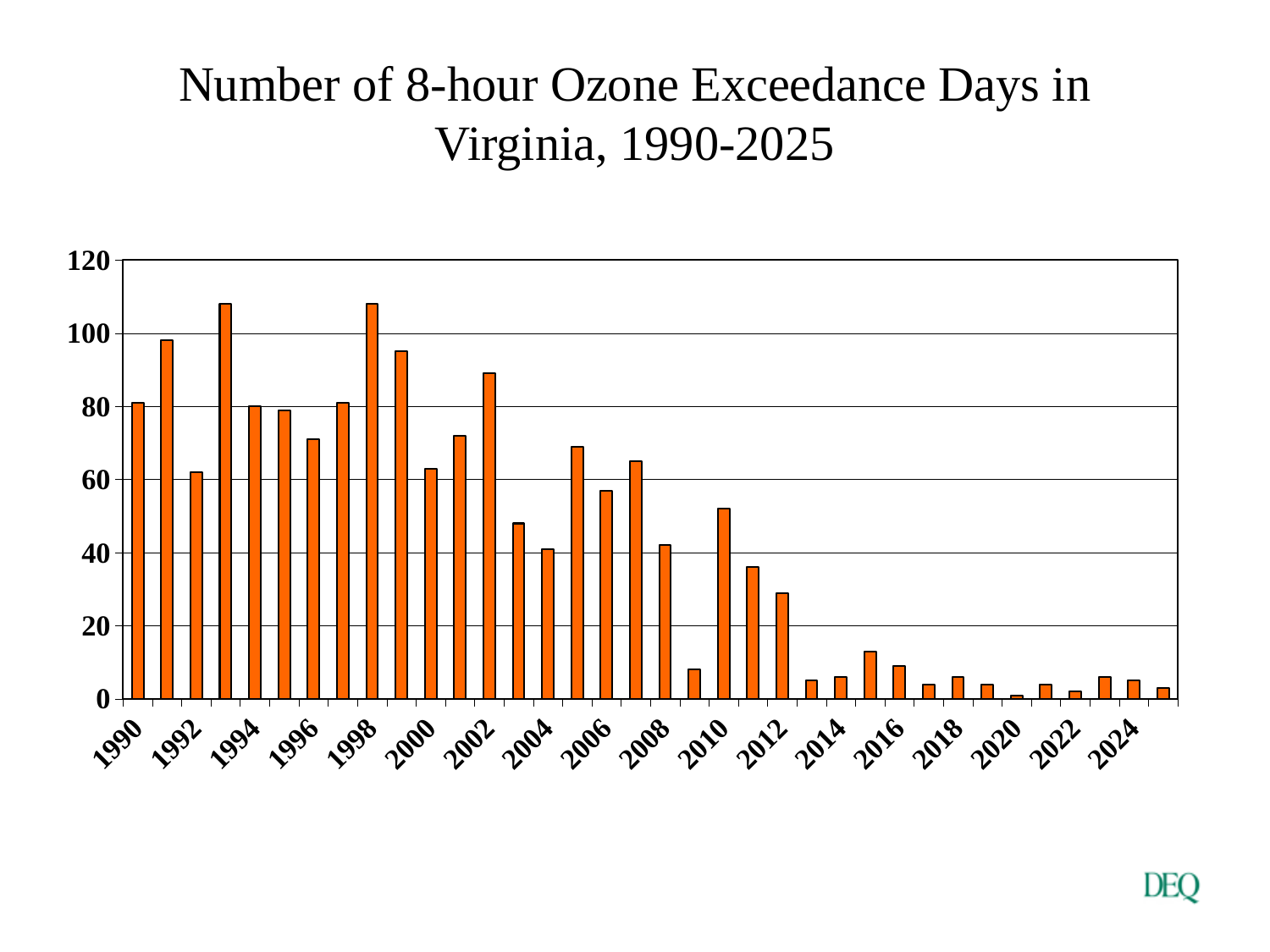
Which year has more exceedance days, 1990 or 1992? 1990 Is the value for 2010 greater or less than 40? greater What is the title of the chart? Number of 8-hour Ozone Exceedance Days in Virginia, 1990-2025 Is the value for 1998 greater or less than 100? greater Overall, do the number of exceedance days rise or fall from 1990 to 2025? fall Is the value for 2016 greater or less than 20? less What kind of chart is shown on the slide? bar chart Which year has more exceedance days, 2002 or 2004? 2002 How many years (bars) are plotted in the chart? 36 Which year has the lowest number of 8-hour ozone exceedance days? 2020